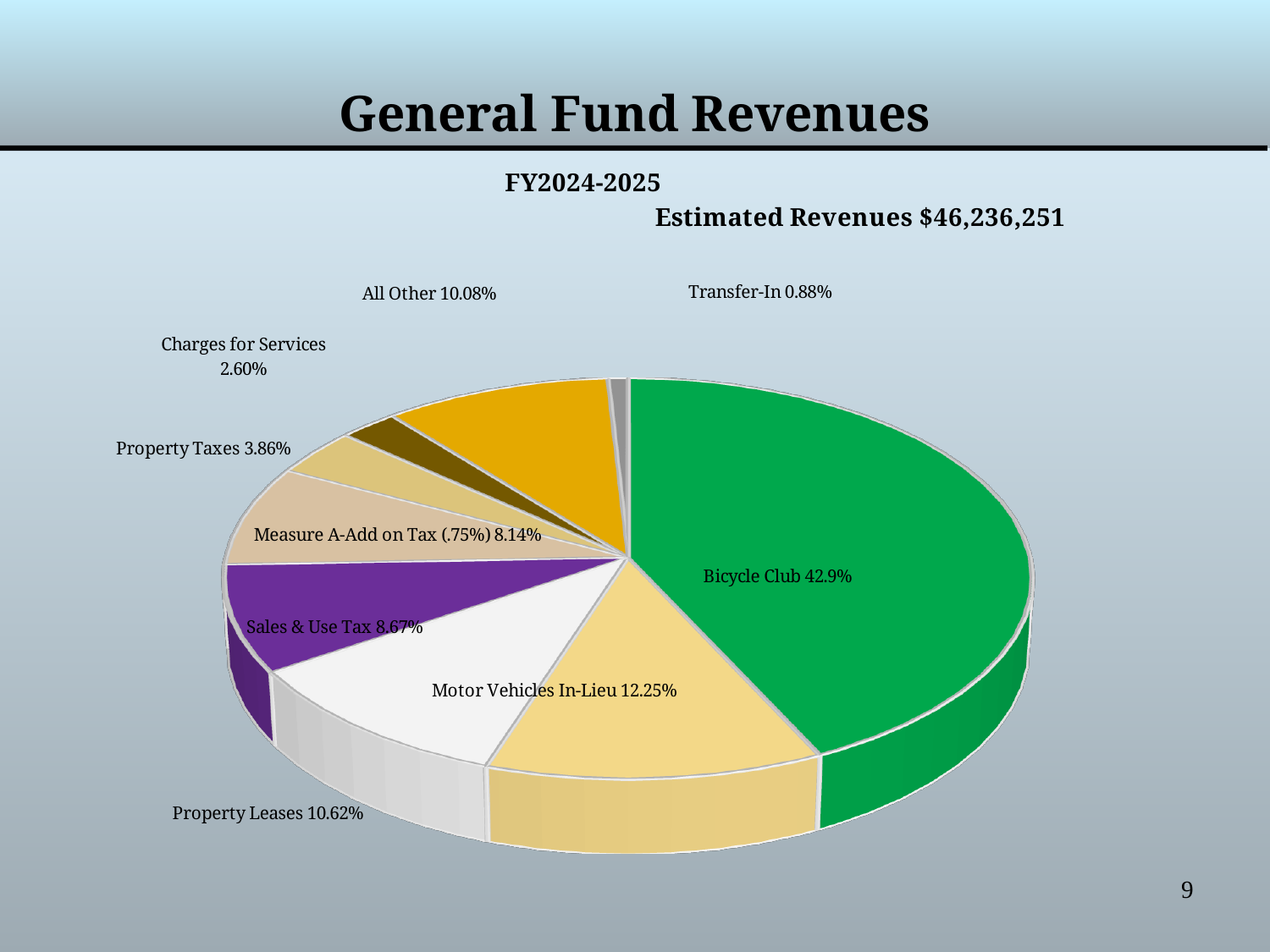
Which revenue source has the largest share of the pie? Bicycle Club What kind of chart is shown on the slide? pie chart What share of General Fund Revenues comes from Bicycle Club? 42.9% What total estimated revenue amount is stated above the chart? $46,236,251 What is the difference in percentage points between the Sales & Use Tax share and the Measure A-Add on Tax (.75%) share? 0.53 Which revenue source has the smallest share of the pie? Transfer-In What share of General Fund Revenues comes from Sales & Use Tax? 8.67% How many slices does the pie chart have? 9 What share of General Fund Revenues comes from Property Leases? 10.62% Which has a larger share, Property Leases or All Other? Property Leases